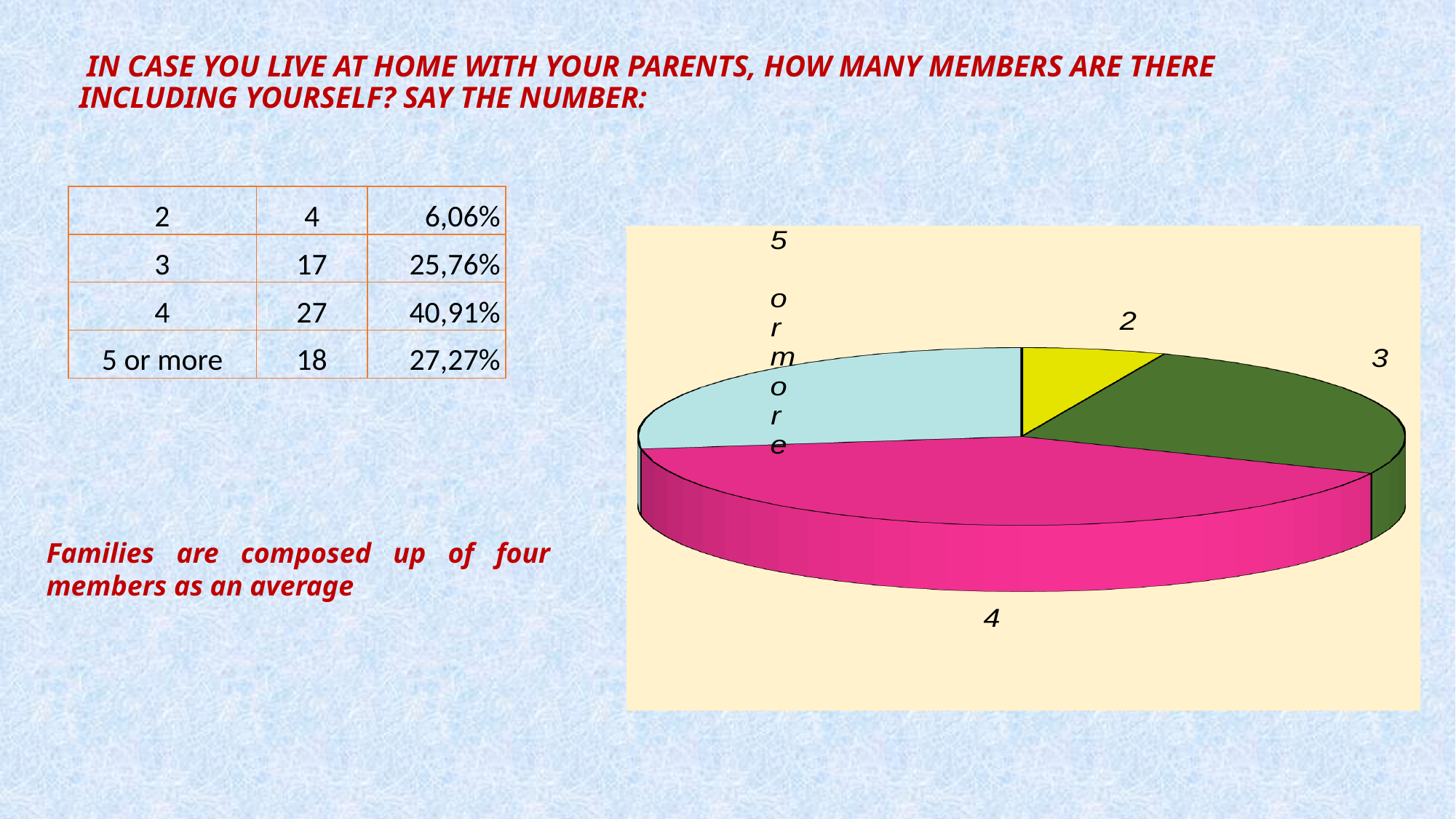
According to the table on the slide, what percentage share corresponds to the category 4? 40,91% According to the table on the slide, what percentage share corresponds to the category 5 or more? 27,27% According to the table on the slide, how many respondents answered 2? 4 Which slice is larger in the pie chart, the one for 3 or the one for 4? 4 Which category has the largest slice of the pie chart? 4 How many slices does the pie chart have? 4 Which category has the smallest slice of the pie chart? 2 Using the counts in the table, what is the difference between the number of respondents answering 4 and those answering 3? 10 Which slice is larger in the pie chart, the one for 2 or the one for 5 or more? 5 or more According to the table on the slide, how many respondents answered 3? 17 What kind of chart is shown on the slide? pie chart What colour is the slice for category 4 in the pie chart? pink